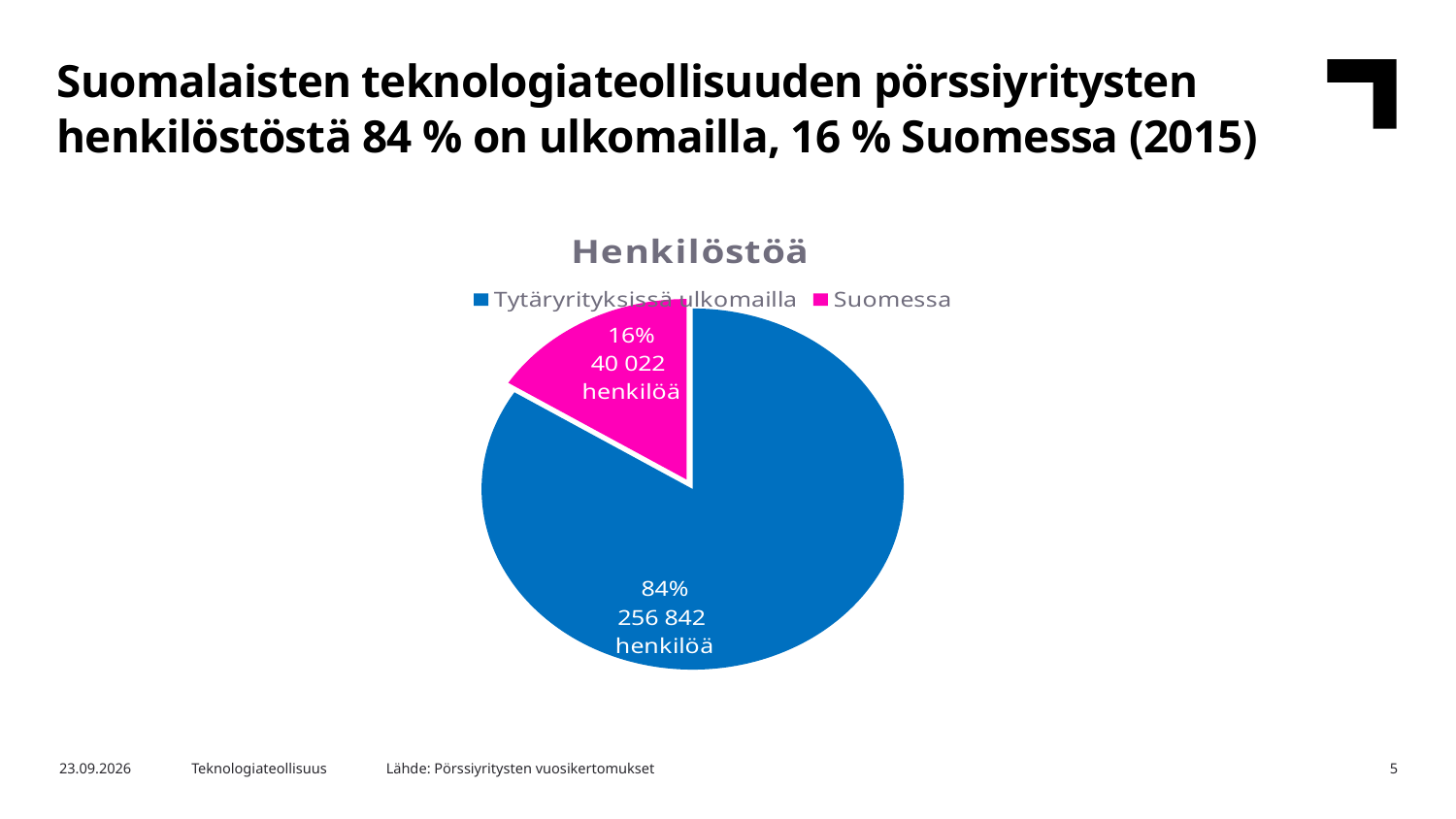
How many people does the 'Tytäryrityksissä ulkomailla' slice represent? 256 842 henkilöä What share of the pie does the 'Suomessa' slice represent? 16% How many slices does the pie chart have? 2 How many entries does the legend list? 2 What is the title of the chart? Henkilöstöä Which slice is the smallest? Suomessa What kind of chart is shown on the slide? Pie chart Which is larger, the 'Suomessa' slice or the 'Tytäryrityksissä ulkomailla' slice? Tytäryrityksissä ulkomailla Which slice is the largest? Tytäryrityksissä ulkomailla What is the difference in headcount between 'Tytäryrityksissä ulkomailla' and 'Suomessa'? 216 820 What share of the pie does the 'Tytäryrityksissä ulkomailla' slice represent? 84% How many people does the 'Suomessa' slice represent? 40 022 henkilöä